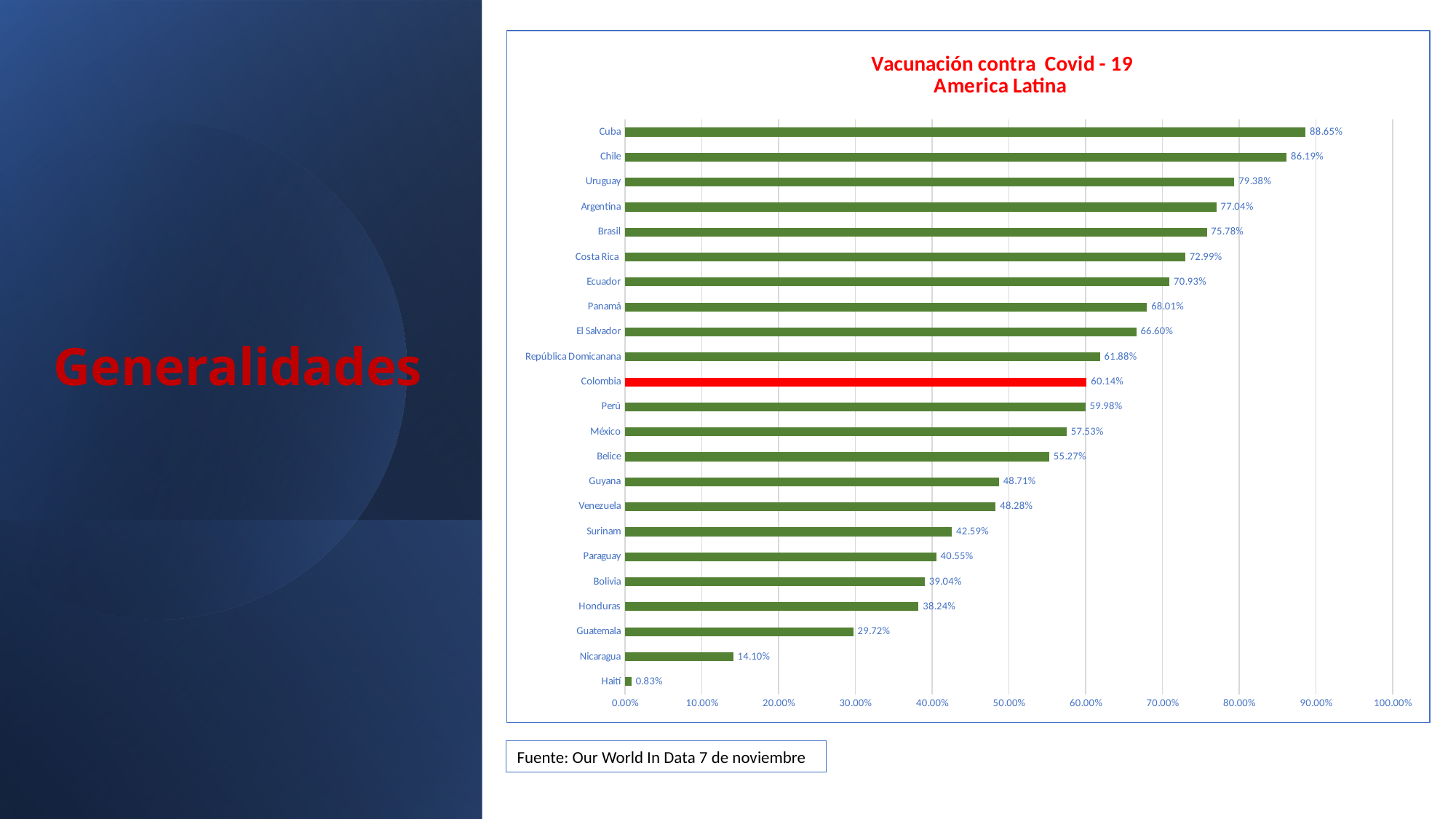
What is the difference between the values for Cuba and Chile? 2.46% What is the value for Haití? 0.83% Which country has the lowest value? Haití What is the value for Colombia? 60.14% What is the difference between the values for Guatemala and Nicaragua? 15.62% Is the value for Surinam greater or less than 50.00%? less What is the value for Costa Rica? 72.99% What kind of chart is shown on the slide? Bar chart Which country has the highest value? Cuba How many countries are shown in the chart? 23 Which country's bar is coloured red instead of green? Colombia Which has a larger value, Brasil or Ecuador? Brasil